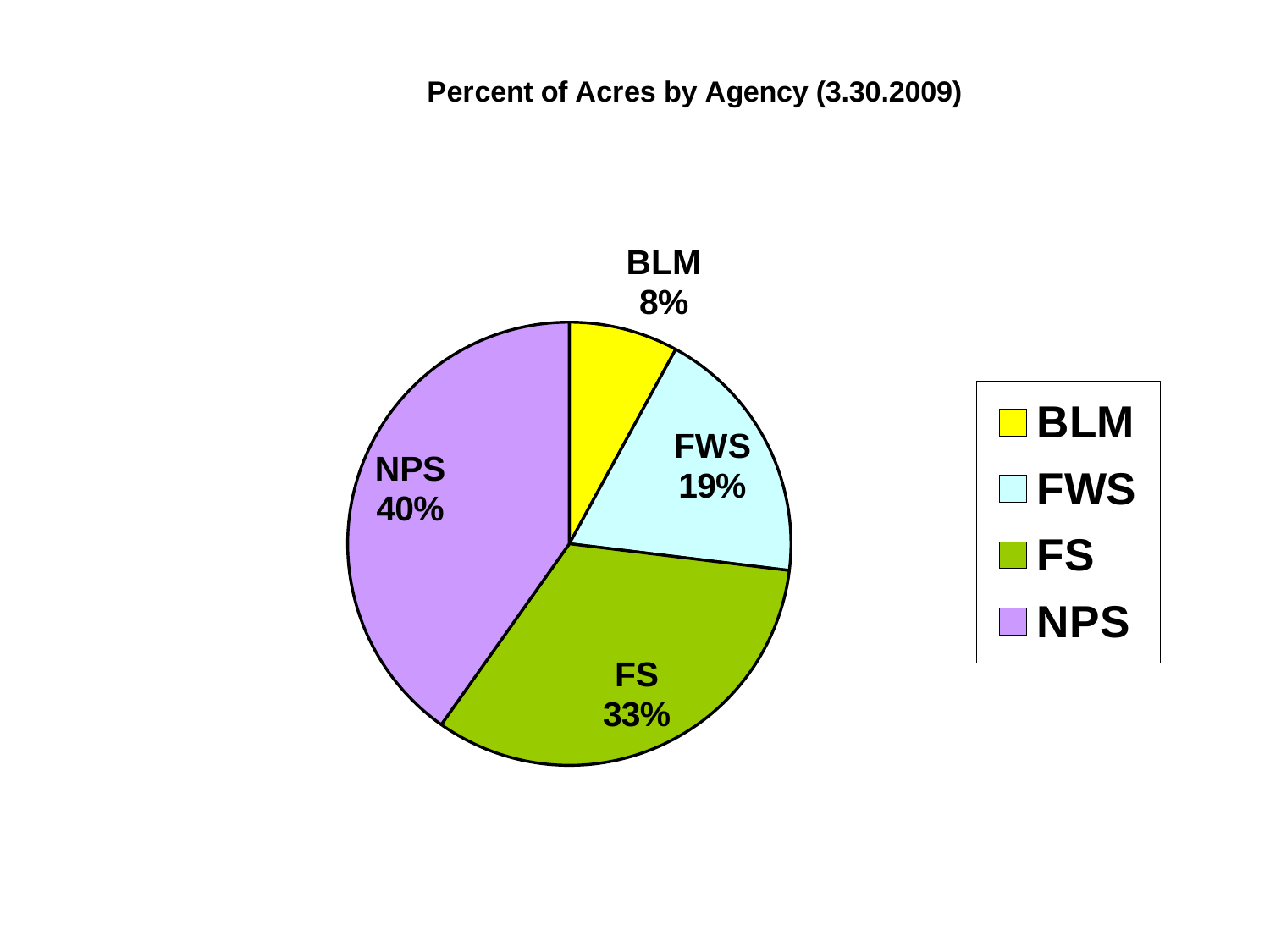
What percentage of acres is attributed to FWS? 19% What type of chart is shown on the slide? Pie chart What percentage of acres is attributed to NPS? 40% Which agency has the smallest share of acres? BLM What percentage of acres is attributed to BLM? 8% What is the difference in percentage points between the FWS and BLM shares? 11 What is the title of the chart? Percent of Acres by Agency (3.30.2009) Which agency has the largest share of acres? NPS What colour is the FS slice in the pie chart? Green Which has a larger share of acres, FS or FWS? FS What is the difference in percentage points between the NPS and FS shares? 7 How many agencies are shown in the pie chart? 4